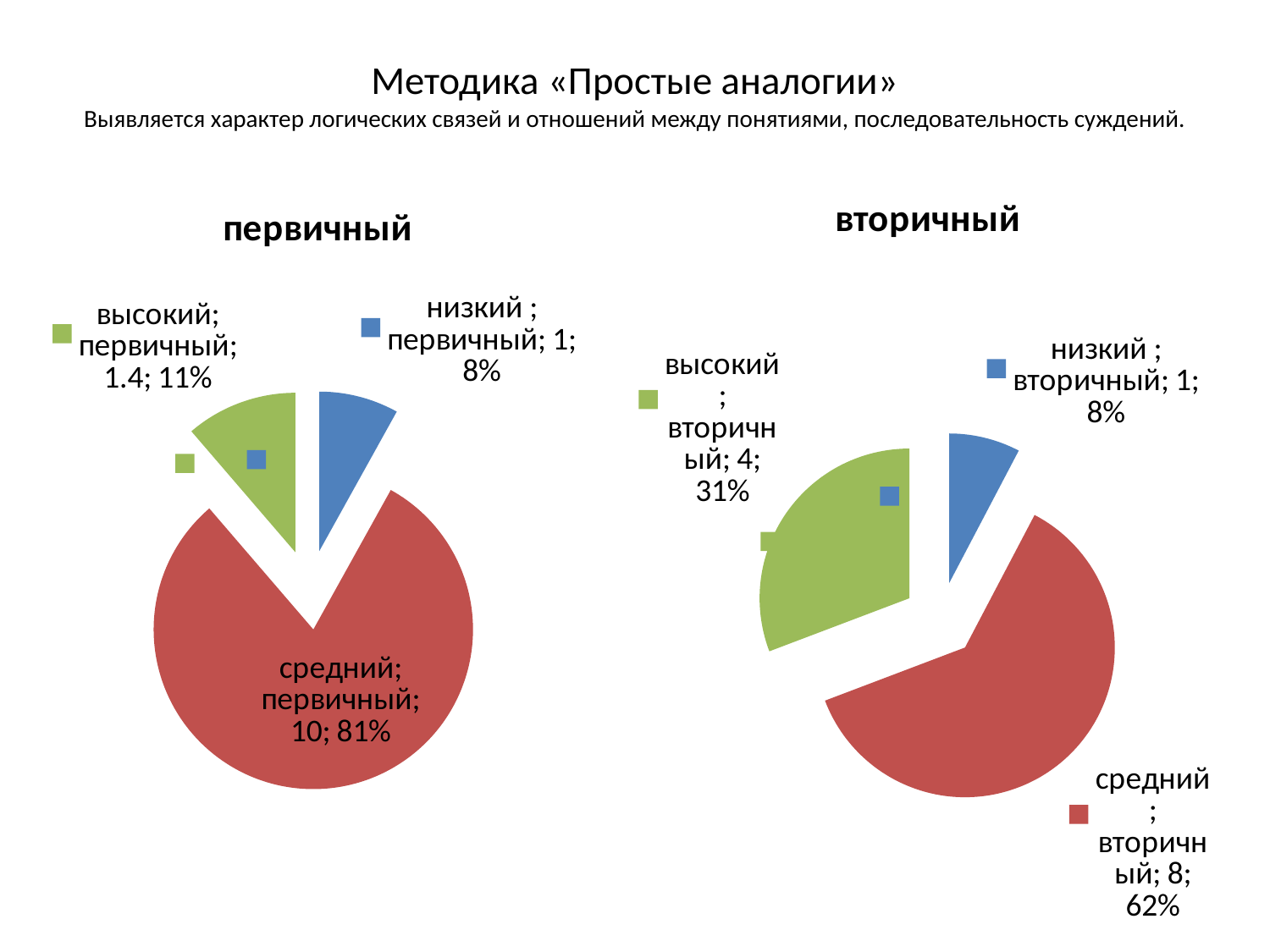
In the "первичный" chart, what value is shown for the "средний" slice? 10 In the "первичный" chart, what value is shown for the "высокий" slice? 1.4 What colour is the "средний" slice in the "первичный" chart? red In the "первичный" chart, what percentage share does the "низкий" slice have? 8% In the "первичный" chart, which category has the largest slice? средний In the "вторичный" chart, what percentage share does the "средний" slice have? 62% What type of chart is the "первичный" chart? pie chart In the "вторичный" chart, what is the difference between the values for "средний" and "высокий"? 4 In the "вторичный" chart, what value is shown for the "высокий" slice? 4 In the "вторичный" chart, which is larger: the "высокий" slice or the "низкий" slice? высокий How many slices does the "вторичный" chart have? 3 In the "вторичный" chart, which category has the smallest slice? низкий